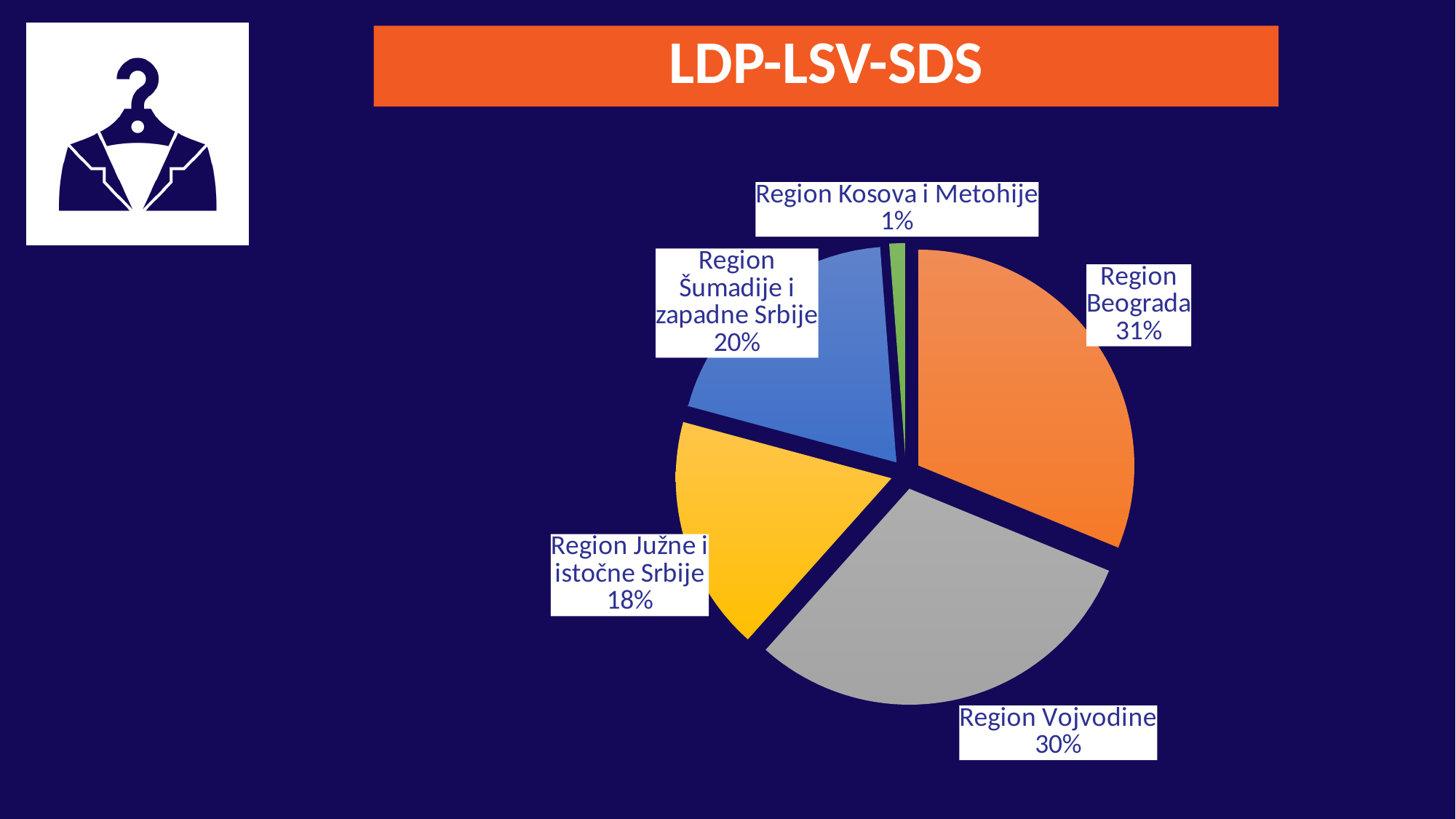
What is the difference between the shares of Region Šumadije i zapadne Srbije and Region Južne i istočne Srbije? 2% Which region has the smallest slice of the pie? Region Kosova i Metohije What is the value shown for Region Kosova i Metohije? 1% What is the value shown for Region Vojvodine? 30% What is the title shown above the chart? LDP-LSV-SDS What is the value shown for Region Šumadije i zapadne Srbije? 20% What kind of chart is shown on the slide? Pie chart How many regions are shown in the pie chart? 5 What share of the pie does Region Beograda hold? 31% Which region has the largest slice of the pie? Region Beograda Which is larger, the share for Region Vojvodine or the share for Region Šumadije i zapadne Srbije? Region Vojvodine What is the value shown for Region Južne i istočne Srbije? 18%